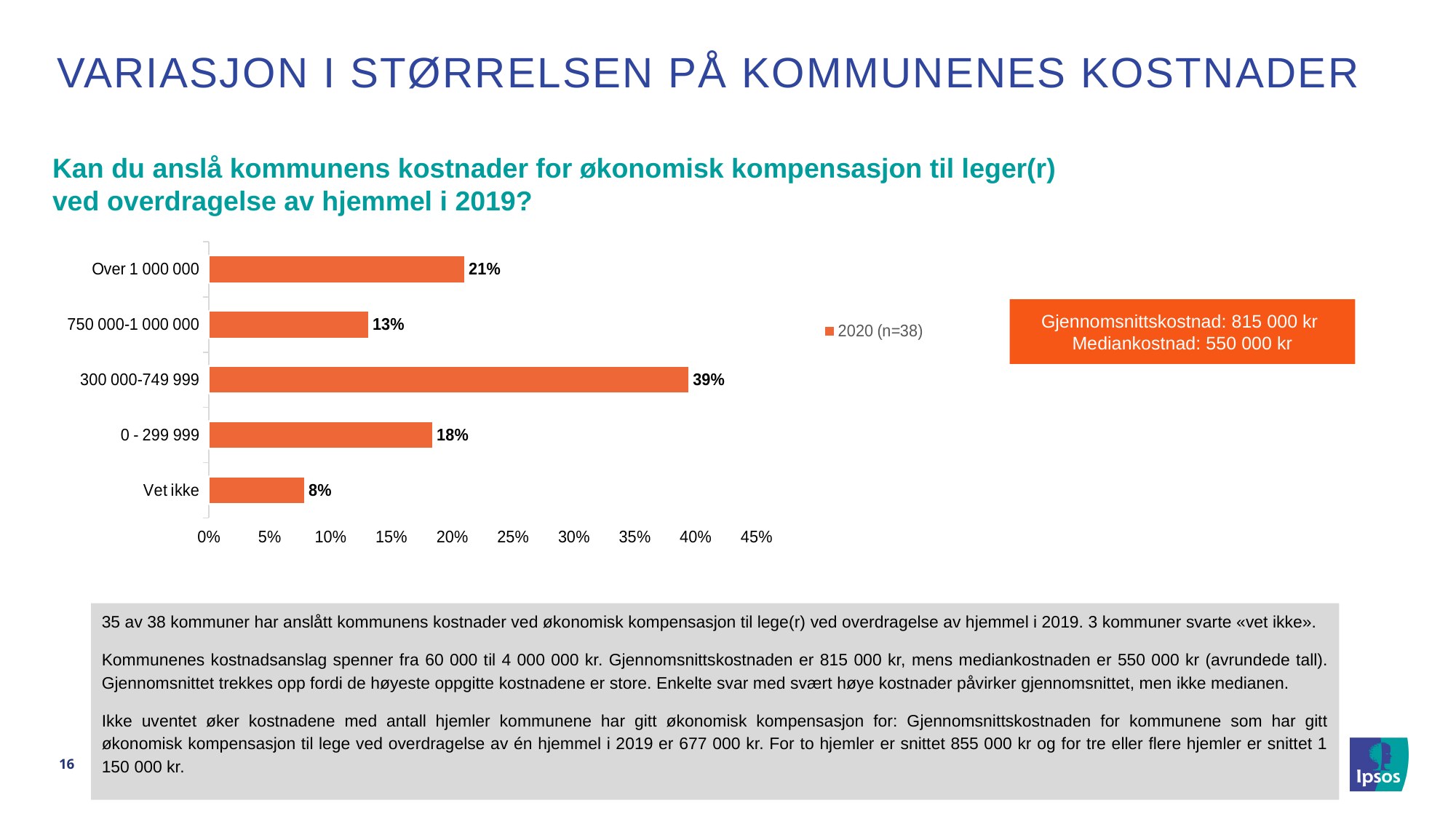
What percentage answered 'Vet ikke'? 8% Which category has the lowest value? Vet ikke How many series does the legend list? 1 What is the difference between the values for '300 000-749 999' and 'Over 1 000 000'? 18 percentage points Which category has the highest value? 300 000-749 999 What is the value for the '0 - 299 999' category? 18% What is the value for the 'Over 1 000 000' category? 21% What kind of chart is shown on the slide? Bar chart Which is larger: the value for '750 000-1 000 000' or the value for '0 - 299 999'? 0 - 299 999 What is the legend entry for the series shown in the chart? 2020 (n=38) What percentage of municipalities estimated costs of 300 000-749 999? 39% How many categories are shown on the chart? 5